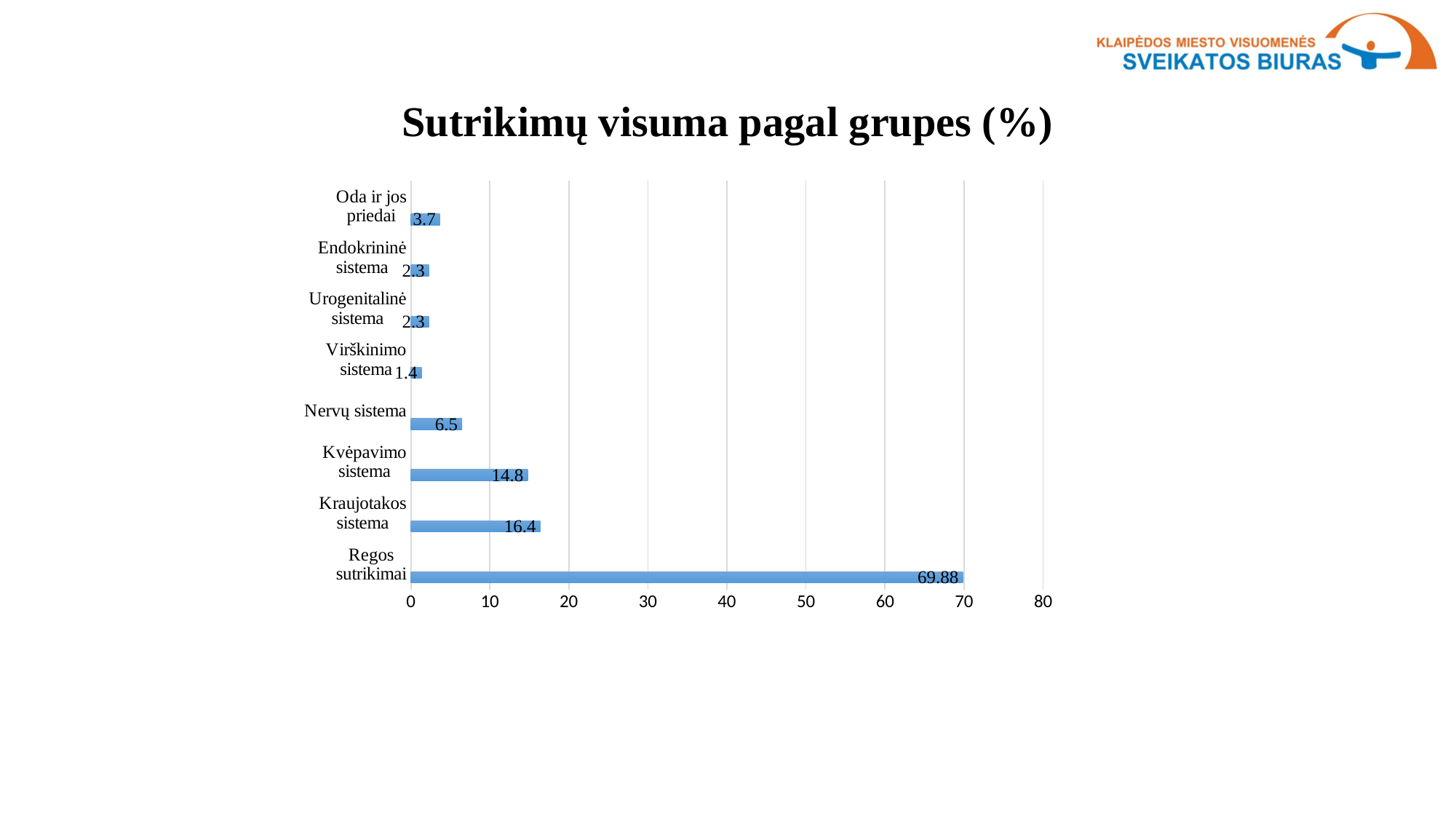
Which is larger, the value for Nervų sistema or the value for Oda ir jos priedai? Nervų sistema Which category has the highest value? Regos sutrikimai What is the value for Regos sutrikimai? 69.88 What is the difference between the values for Kraujotakos sistema and Kvėpavimo sistema? 1.6 Is the value for Regos sutrikimai greater or less than 60? greater What type of chart is shown on the slide? Bar chart What is the value for Virškinimo sistema? 1.4 Which category has the lowest value? Virškinimo sistema How many categories are shown in the chart? 8 What is the value for Kvėpavimo sistema? 14.8 What is the value for Kraujotakos sistema? 16.4 What is the value for Nervų sistema? 6.5